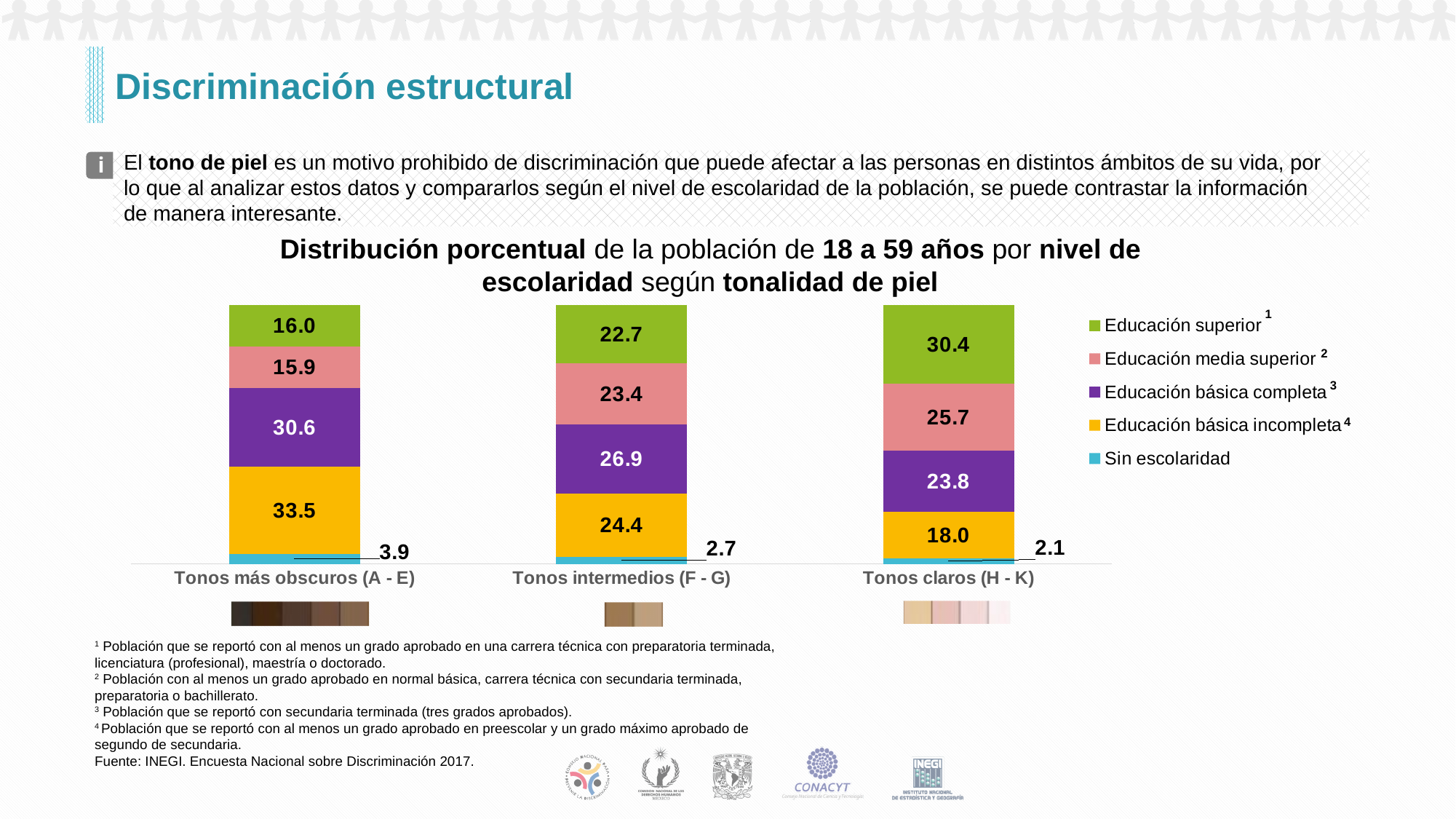
What type of chart is shown on the slide? Stacked bar chart What is the value for Educación superior in the Tonos claros (H - K) category? 30.4 Which skin-tone category has the lowest value for Sin escolaridad? Tonos claros (H - K) How does the value for Educación básica incompleta change from Tonos más obscuros (A - E) to Tonos claros (H - K)? It falls How many series does the legend list? 5 What is the value for Sin escolaridad in the Tonos intermedios (F - G) category? 2.7 What is the total of the stacked bar for Tonos claros (H - K)? 100.0 What is the difference between the Educación superior values for Tonos claros (H - K) and Tonos más obscuros (A - E)? 14.4 How many skin-tone categories are shown on the x axis? 3 Which skin-tone category has the highest value for Educación superior? Tonos claros (H - K) Which is larger: Educación básica completa for Tonos más obscuros (A - E) or for Tonos claros (H - K)? Tonos más obscuros (A - E) What is the value for Educación básica incompleta in the Tonos más obscuros (A - E) category? 33.5